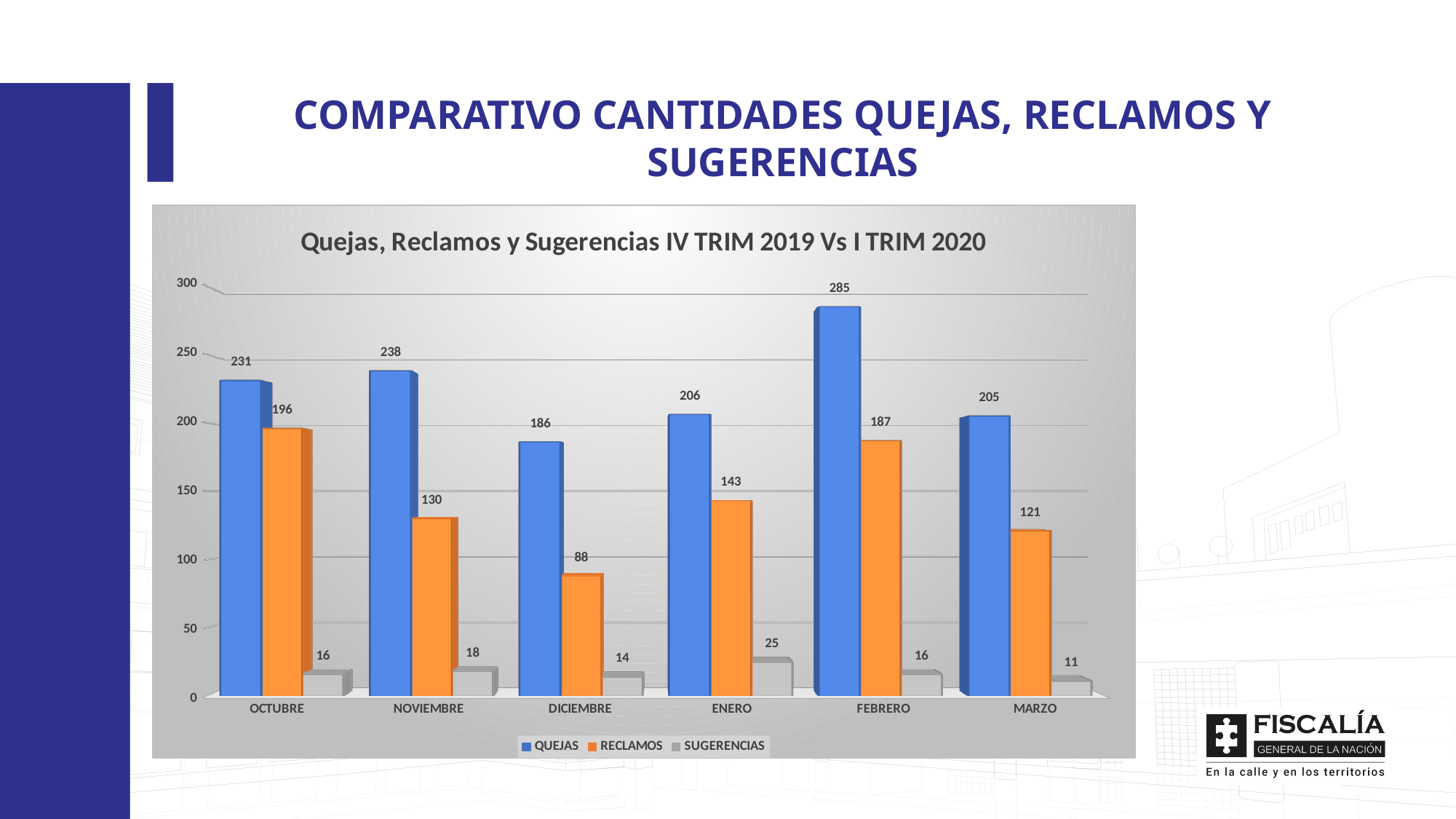
Which month has the lowest value for SUGERENCIAS? MARZO How many months are shown on the x axis? 6 What is the value of SUGERENCIAS for ENERO? 25 What is the difference between QUEJAS and RECLAMOS in OCTUBRE? 35 Which month has the lowest value for RECLAMOS? DICIEMBRE How many series does the legend list? 3 Which month has the highest value for QUEJAS? FEBRERO Which is larger, RECLAMOS in NOVIEMBRE or RECLAMOS in MARZO? NOVIEMBRE What is the value of QUEJAS for FEBRERO? 285 What is the value of RECLAMOS for DICIEMBRE? 88 What is the title of the chart? Quejas, Reclamos y Sugerencias IV TRIM 2019 Vs I TRIM 2020 What kind of chart is shown on the slide? Bar chart